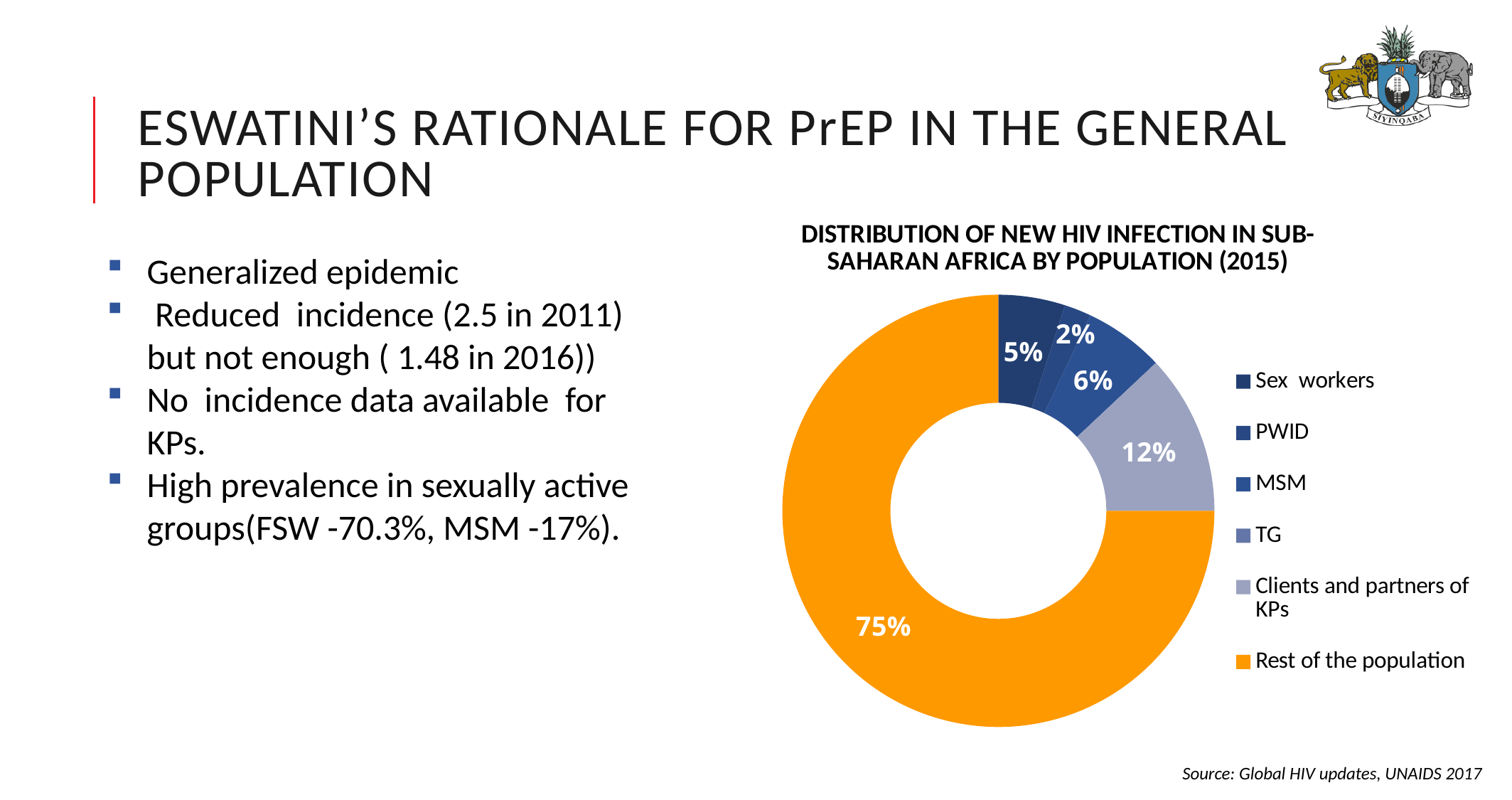
What share of new HIV infections is attributed to PWID? 2% What is the difference in percentage points between the share for the rest of the population and the share for clients and partners of KPs? 63 percentage points What source is cited for the chart? Global HIV updates, UNAIDS 2017 What share of new HIV infections is attributed to sex workers? 5% How many categories does the chart's legend list? 6 What share of new HIV infections is attributed to MSM? 6% What is the title of the chart? Distribution of new HIV infection in sub-Saharan Africa by population (2015) What share of new HIV infections is attributed to the rest of the population? 75% Which is larger: the share for clients and partners of KPs or the share for MSM? Clients and partners of KPs What share of new HIV infections is attributed to clients and partners of KPs? 12% What kind of chart is shown on the slide? Doughnut (pie) chart Which population group accounts for the largest share of new HIV infections? Rest of the population